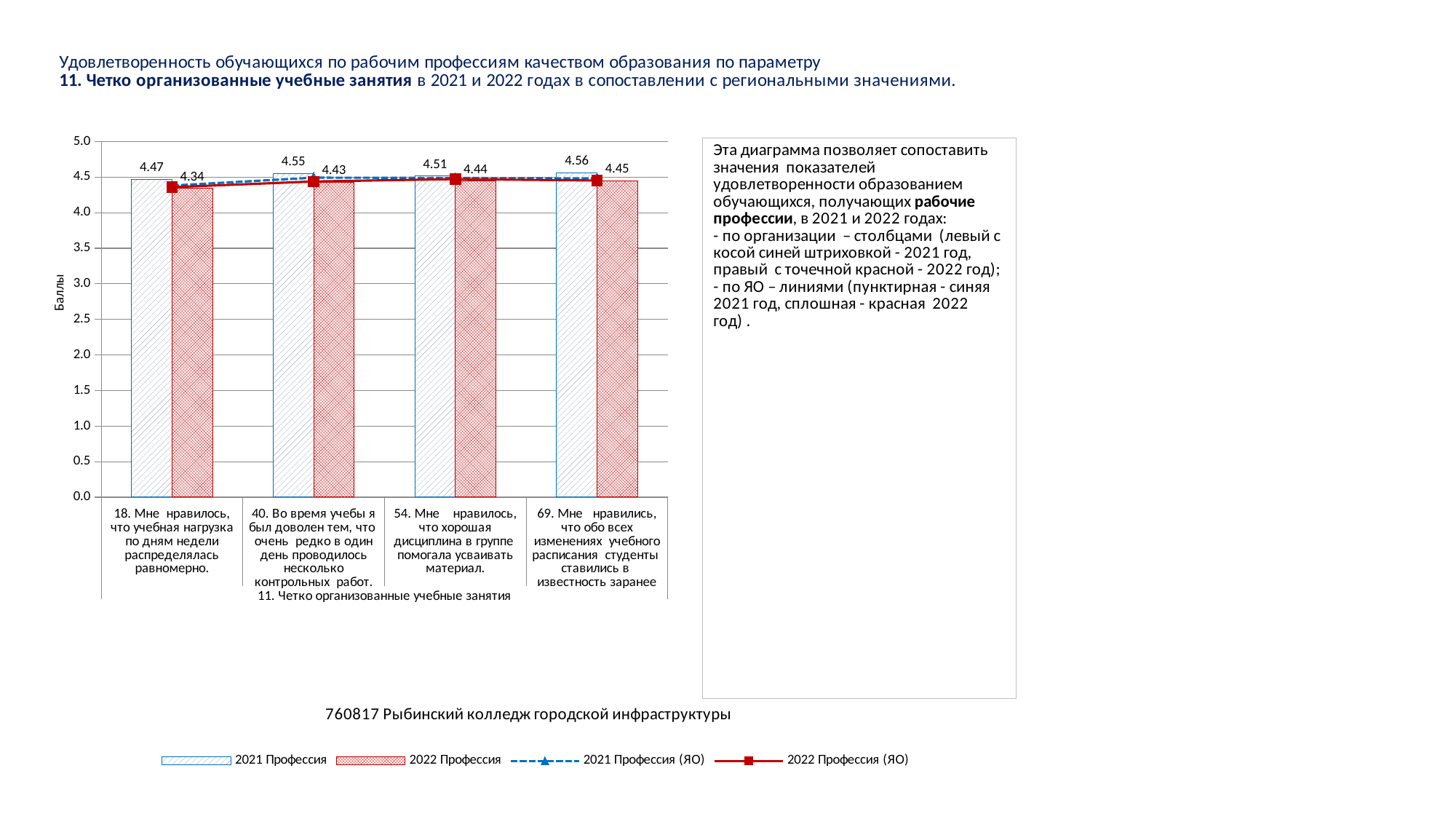
What is the label of the y axis of the chart? Баллы What is the value of the 2022 Профессия bar for question 54 (Мне нравилось, что хорошая дисциплина в группе помогала усваивать материал)? 4.44 What kind of chart is shown on the slide? Bar chart with line series What is the value of the 2021 Профессия bar for question 18 (Мне нравилось, что учебная нагрузка по дням недели распределялась равномерно)? 4.47 What is the difference between the 2021 Профессия and 2022 Профессия bars for question 18? 0.13 Which question has the highest 2021 Профессия bar? 69. Мне нравились, что обо всех изменениях учебного расписания студенты ставились в известность заранее Which question has the lowest 2022 Профессия bar? 18. Мне нравилось, что учебная нагрузка по дням недели распределялась равномерно. How many questions (categories) are shown on the x axis of the chart? 4 How many series does the chart legend list? 4 What is the value of the 2022 Профессия bar for question 40 (Во время учебы я был доволен тем, что очень редко в один день проводилось несколько контрольных работ)? 4.43 Which is larger for question 69: the 2021 Профессия bar or the 2022 Профессия bar? 2021 Профессия Is the 2022 Профессия value for question 40 greater or less than 4.0? greater